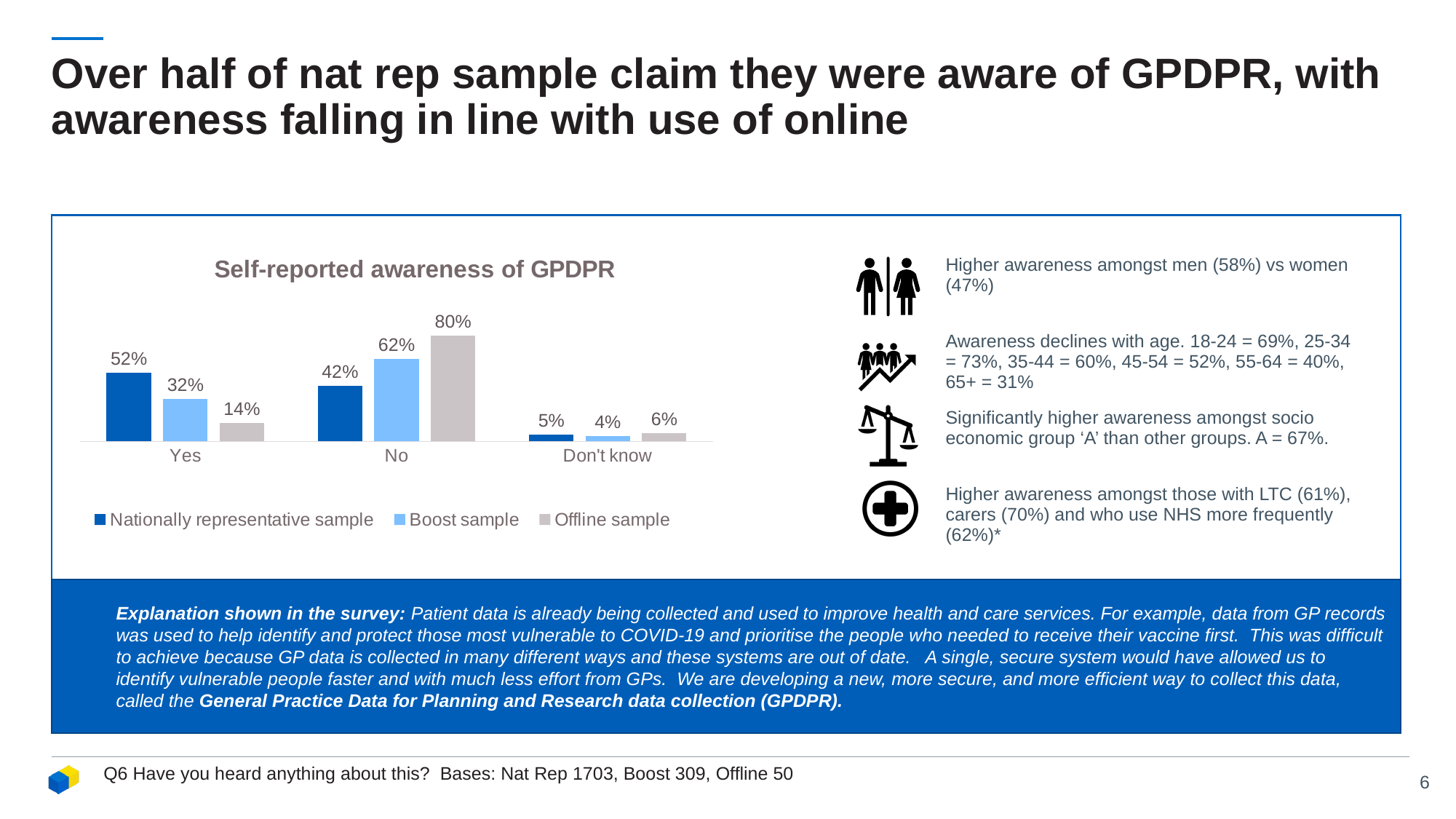
How many categories are shown on the x axis? 3 What is the difference between the Offline sample and the Boost sample in the No category? 18% How many series does the legend list? 3 What is the value for the Nationally representative sample in the Yes category? 52% What is the difference between the Nationally representative sample and the Offline sample in the Yes category? 38% Which sample has the lowest value in the No category? Nationally representative sample What is the title of the chart? Self-reported awareness of GPDPR Which sample has the highest value in the Yes category? Nationally representative sample What kind of chart is shown on the slide? Bar chart What is the value for the Offline sample in the No category? 80% What is the value for the Boost sample in the Don't know category? 4% Which is larger: the Boost sample value for Yes or the Offline sample value for Yes? Boost sample